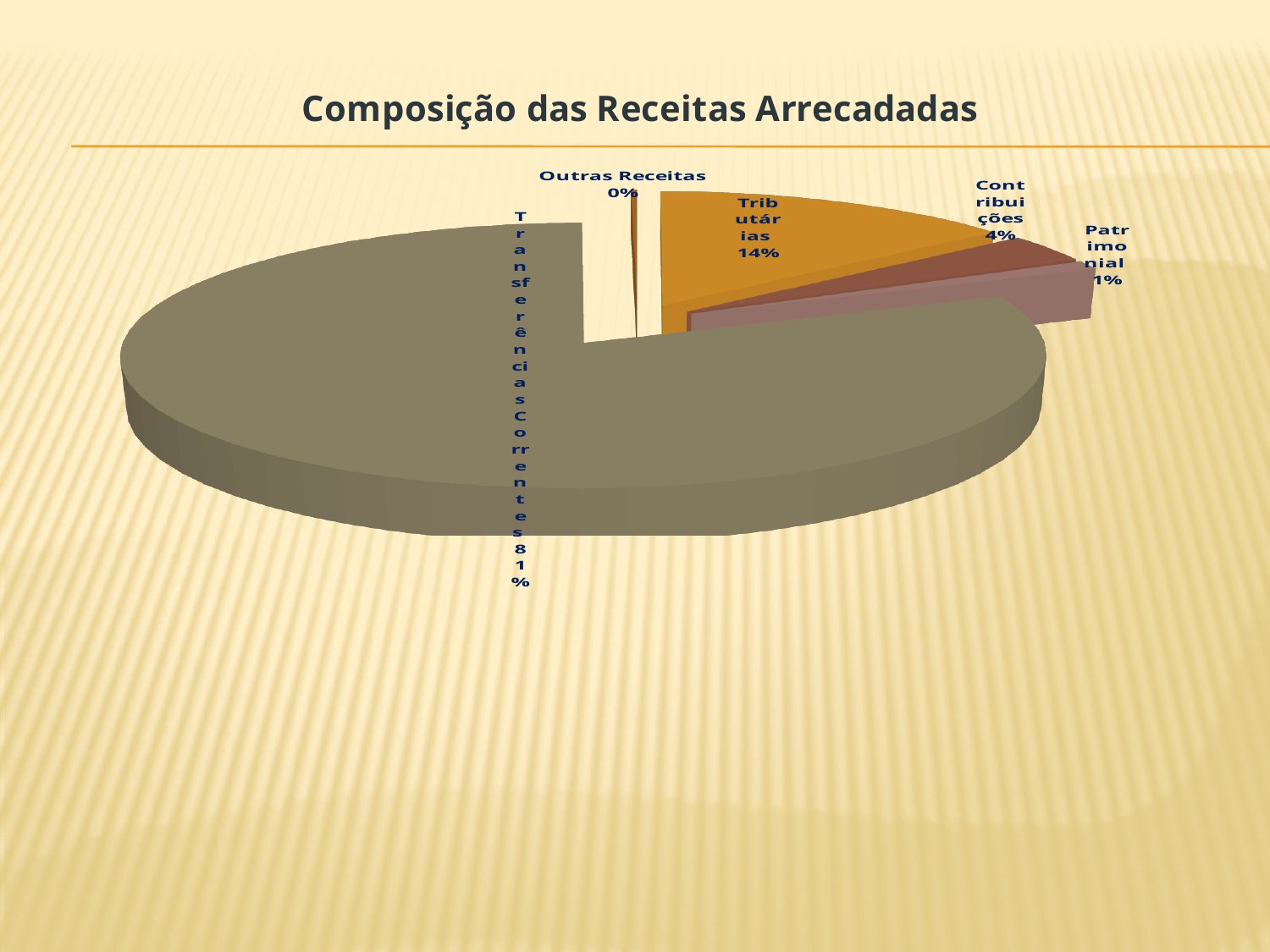
Which category has the smallest slice of the pie? Outras Receitas What share of the pie does Patrimonial represent? 1% What kind of chart is shown on the slide? pie chart Which is larger, the share for Tributárias or the share for Patrimonial? Tributárias What share of the pie does Tributárias represent? 14% What is the difference in percentage points between Tributárias and Contribuições? 10 What share of the pie does Outras Receitas represent? 0% What is the title of the chart? Composição das Receitas Arrecadadas Which category has the largest slice of the pie? Transferências Correntes How many categories are shown in the pie chart? 5